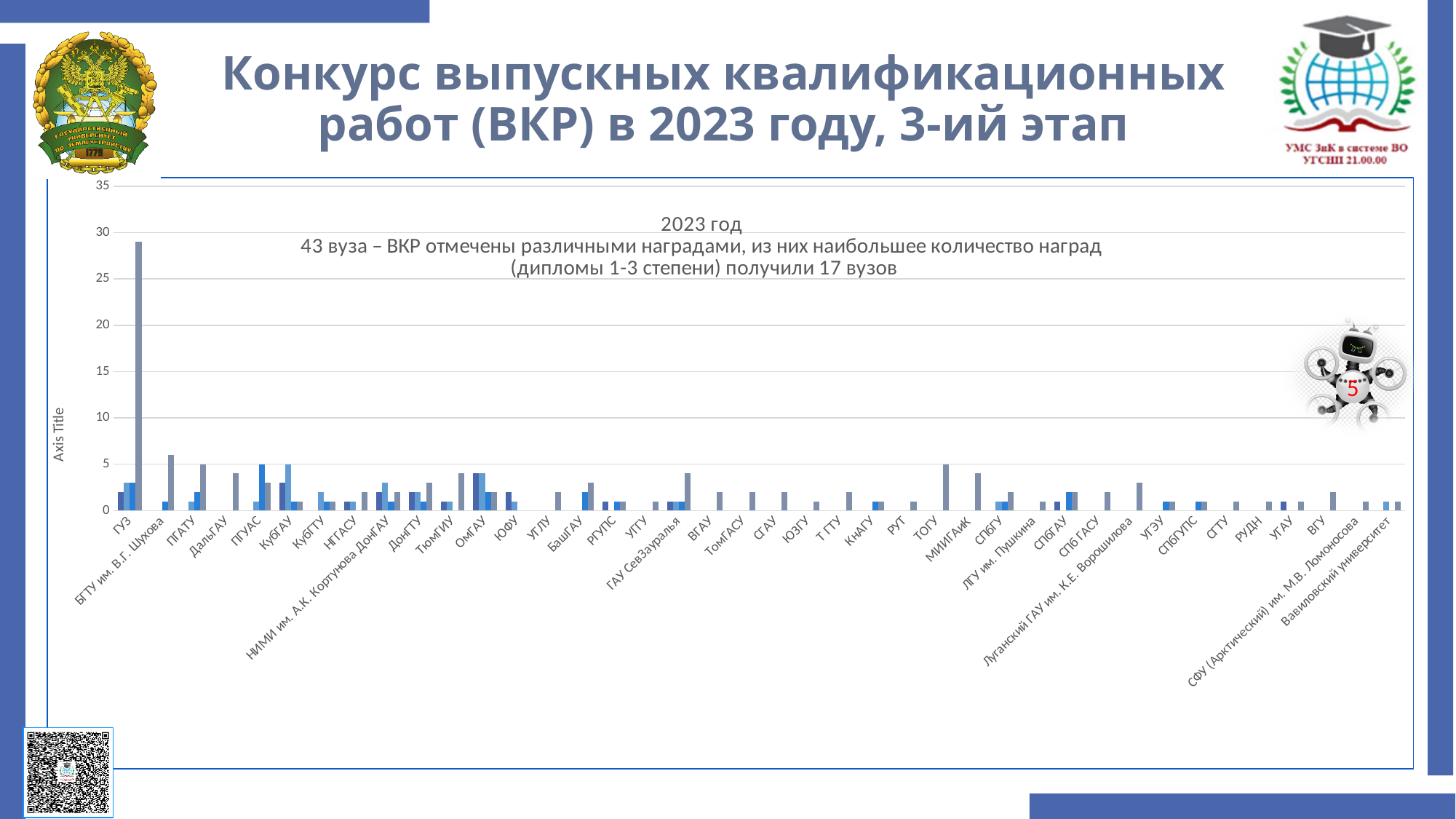
Is the tallest bar for ГУЗ greater or less than 25? greater Which has a taller bar, ГУЗ or ПГАТУ? ГУЗ Is the tallest bar for ТОГУ greater or less than 10? less Is the tallest bar for ПГАТУ greater or less than 10? less What is the label of the vertical axis of the chart? Axis Title Which university has the tallest bar in the chart? ГУЗ Which has a taller bar, ГУЗ or МИИГАиК? ГУЗ What is the highest value shown on the vertical axis of the chart? 35 What kind of chart is shown on the slide? bar chart